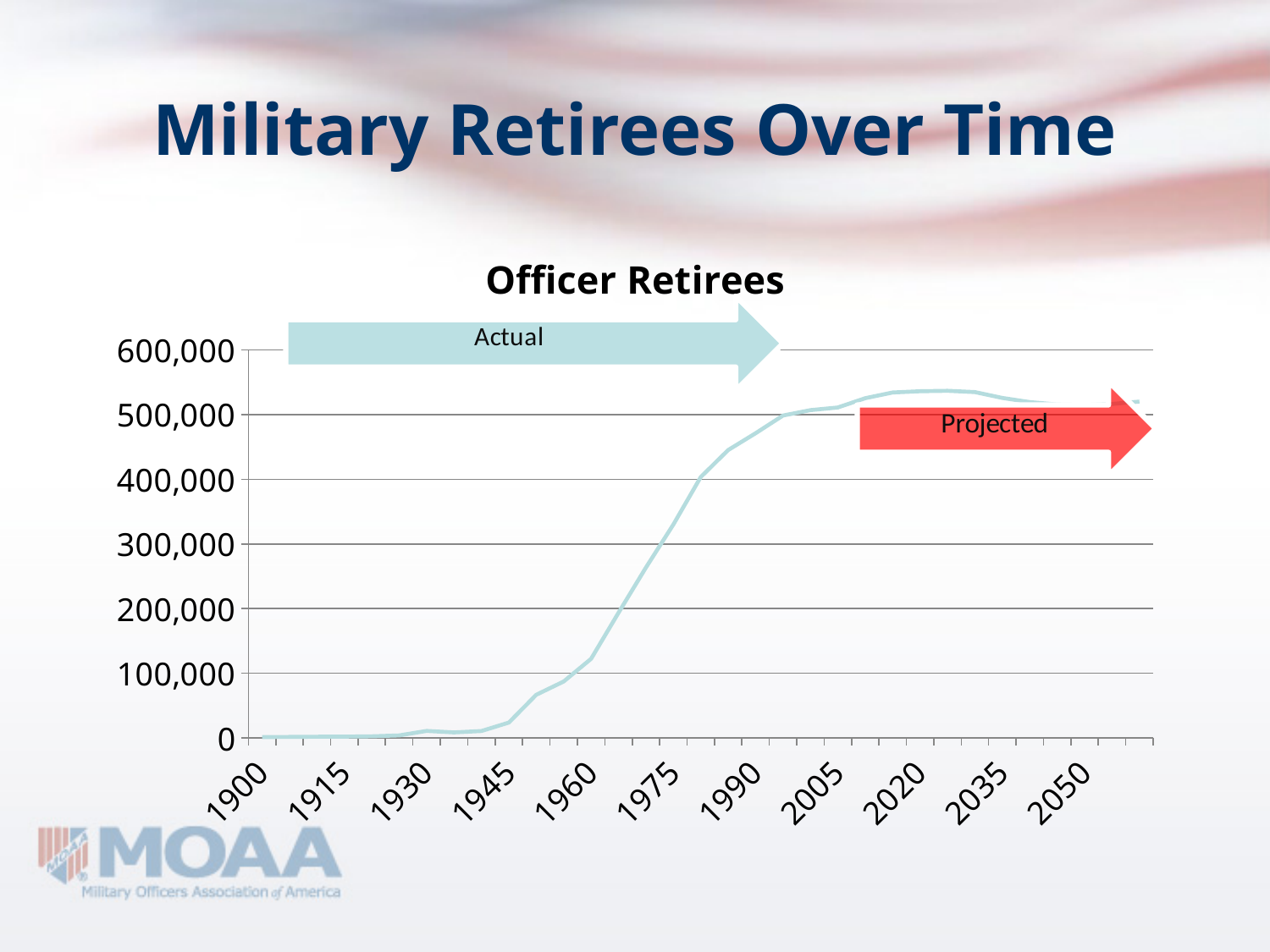
Is the value for 1900 greater or less than 100,000? less Is the value for 1990 greater or less than 400,000? greater Is the value for 2005 greater or less than 400,000? greater What kind of chart is shown on the slide? line chart What are the two labels on the arrows above the chart? Actual and Projected How many year labels are shown on the x axis? 11 What is the title of the chart? Officer Retirees Does the number of officer retirees rise or fall between 1945 and 1990? rise Which is larger, the value for 1960 or the value for 1990? 1990